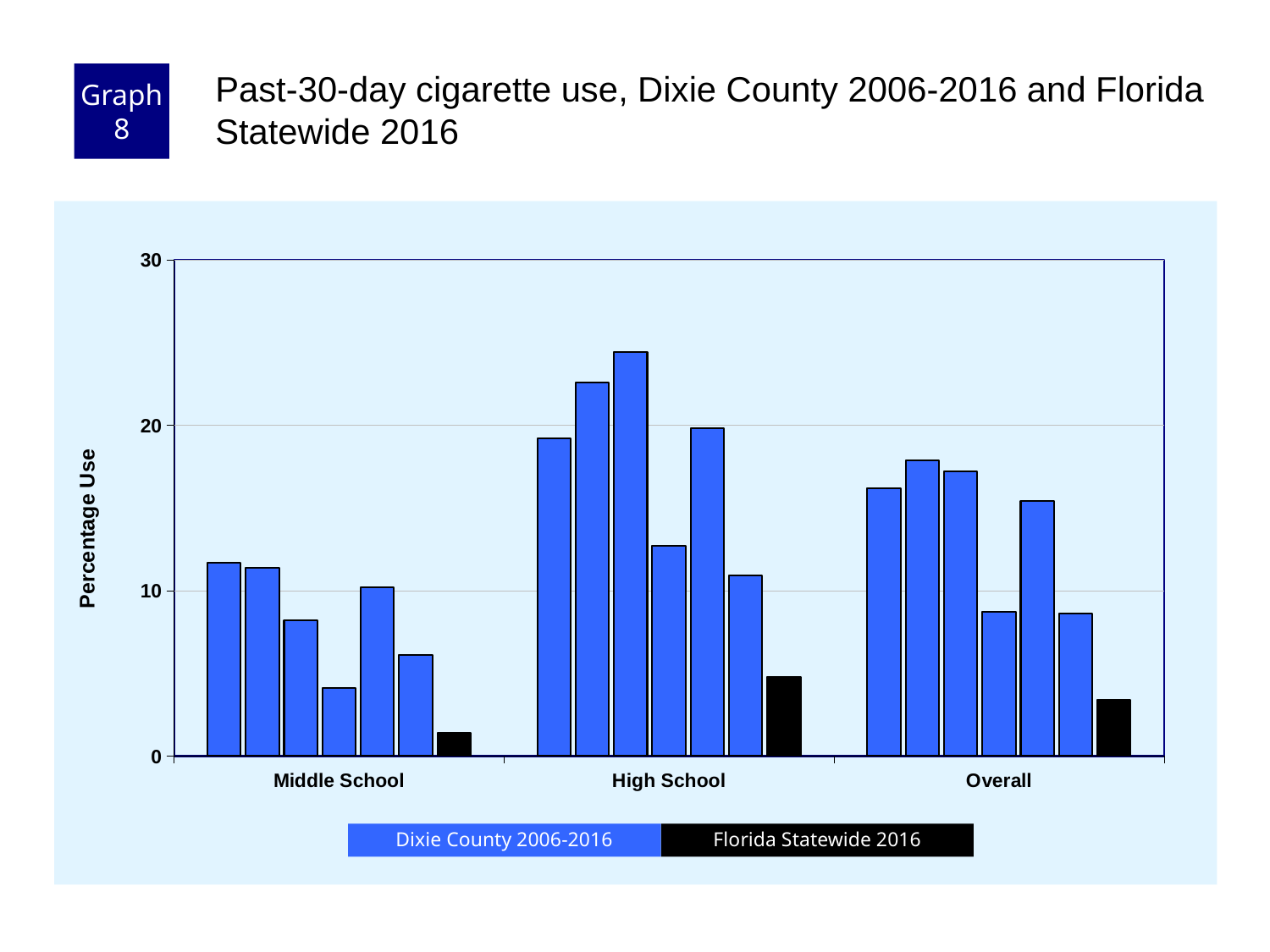
Is the tallest Dixie County 2006-2016 bar in the High School group greater or less than 20? greater What is the label of the y axis? Percentage Use Which category has the lowest Florida Statewide 2016 value? Middle School Which series is drawn in black? Florida Statewide 2016 How many categories are shown along the x axis? 3 Is the Florida Statewide 2016 value for High School greater or less than 10? less Which is larger, the Florida Statewide 2016 value for High School or for Middle School? High School Is the Florida Statewide 2016 value for Middle School greater or less than 10? less How many series does the legend list? 2 Which category contains the tallest bar in the chart? High School What kind of chart is shown on the slide? bar chart